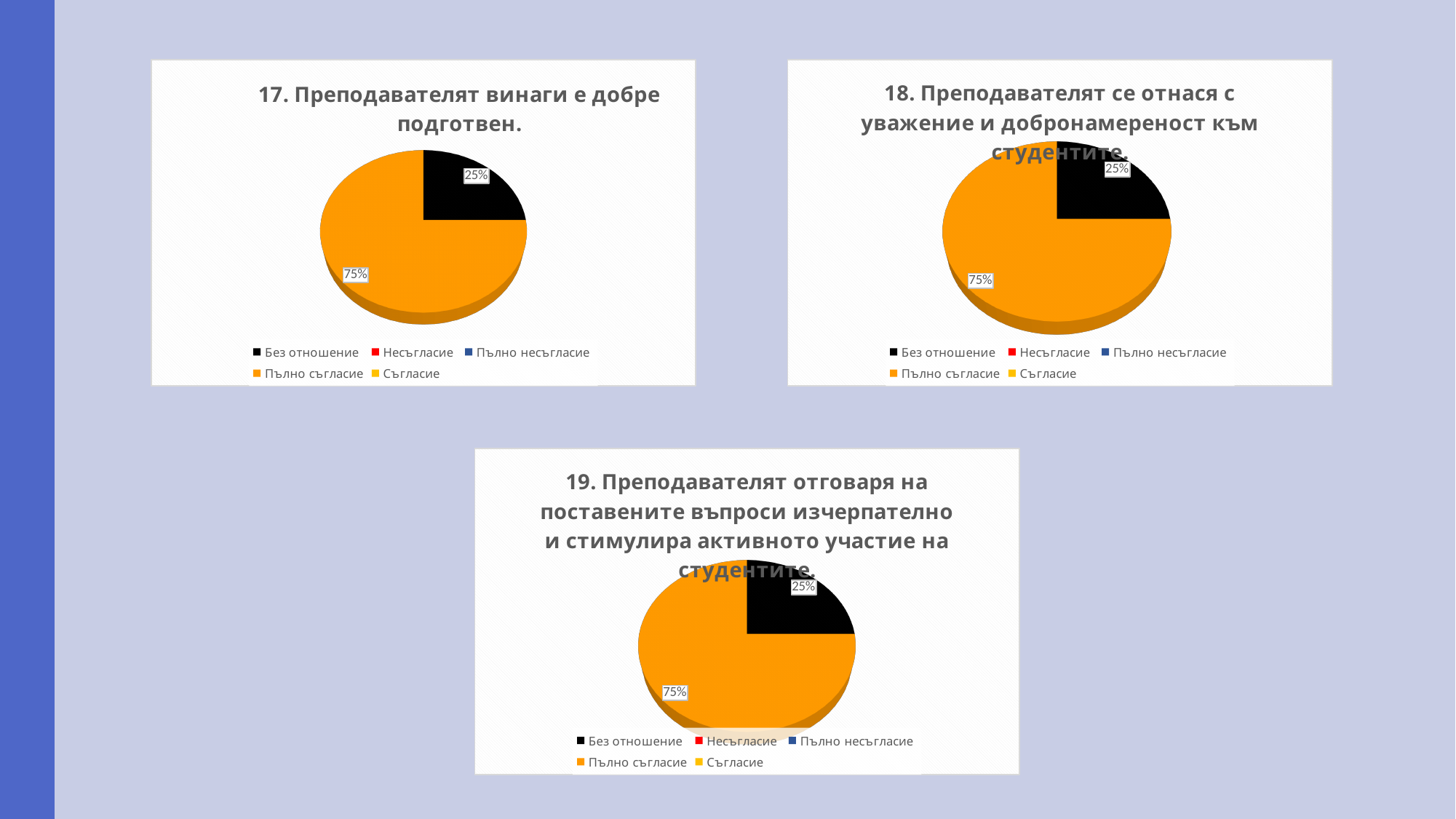
In the bottom chart (19. Преподавателят отговаря на поставените въпроси...), which category has the smallest visible slice? Без отношение In the bottom chart (19. Преподавателят отговаря на поставените въпроси...), what share of the pie is "Пълно съгласие"? 75% How many entries does the legend list in the bottom chart (19. Преподавателят отговаря на поставените въпроси...)? 5 In the chart titled "17. Преподавателят винаги е добре подготвен.", which category has the largest slice? Пълно съгласие In the chart titled "18. Преподавателят се отнася с уважение и добронамереност към студентите.", what colour is the "Пълно съгласие" slice? Orange How many pie charts are shown on the slide? 3 In the chart titled "18. Преподавателят се отнася с уважение и добронамереност към студентите.", which is larger, "Пълно съгласие" or "Без отношение"? Пълно съгласие In the chart titled "18. Преподавателят се отнася с уважение и добронамереност към студентите.", what share of the pie is "Без отношение"? 25% In the chart titled "17. Преподавателят винаги е добре подготвен.", what share of the pie is "Пълно съгласие"? 75% In the chart titled "18. Преподавателят се отнася с уважение и добронамереност към студентите.", what is the difference between the "Пълно съгласие" and "Без отношение" slices? 50% What type of chart is the chart titled "17. Преподавателят винаги е добре подготвен."? Pie chart